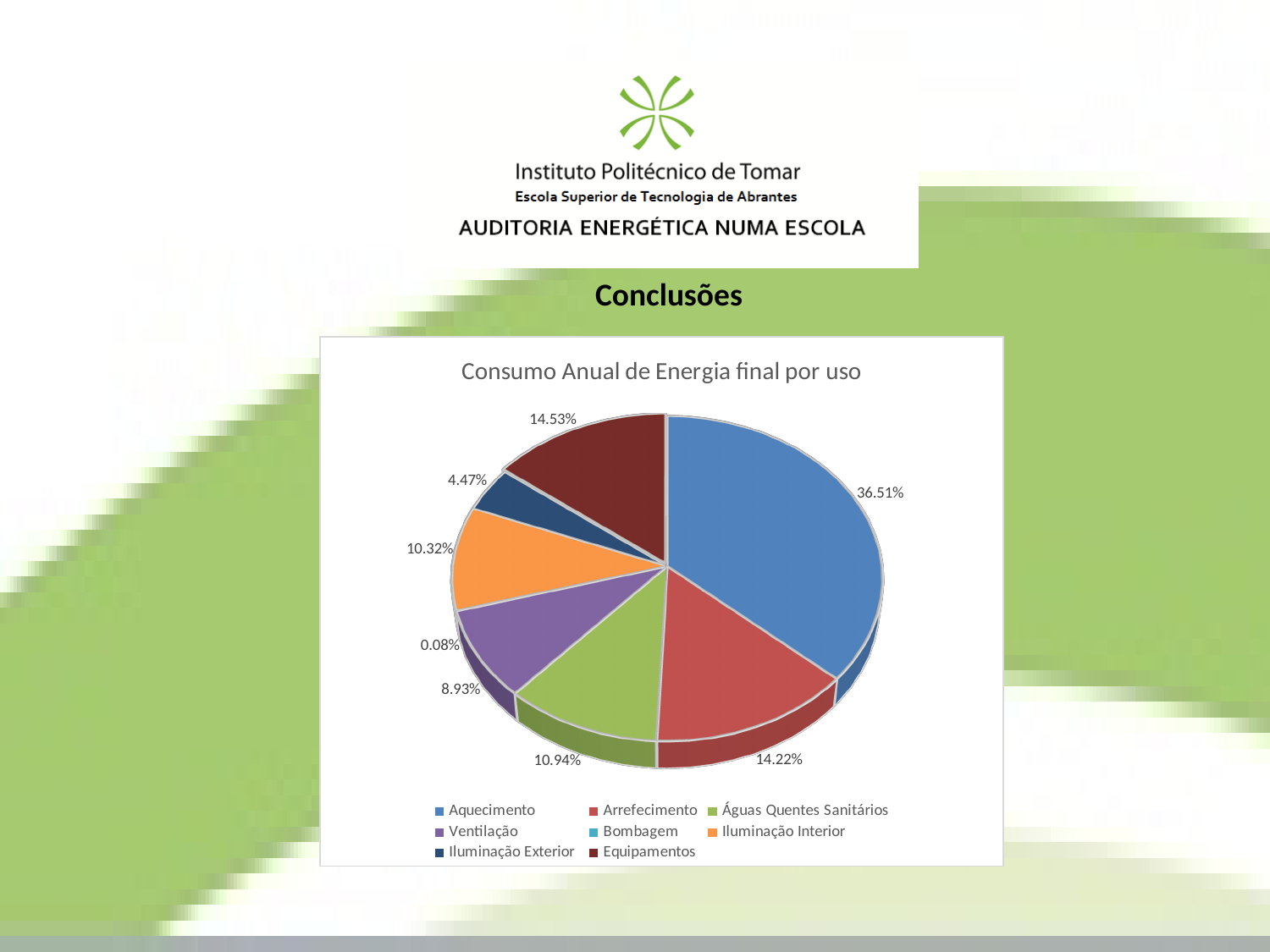
What is the value shown for Arrefecimento? 14.22% Which category has the smallest slice of the pie? Bombagem What is the value shown for Equipamentos? 14.53% What is the value shown for Iluminação Exterior? 4.47% What is the difference between the shares of Aquecimento and Arrefecimento? 22.29% Which category has the largest slice of the pie? Aquecimento What is the value shown for Ventilação? 8.93% How many categories does the legend of the pie chart list? 8 What share of the pie does Aquecimento represent? 36.51% What kind of chart is shown on the slide? pie chart Which is larger, the share of Águas Quentes Sanitários or the share of Iluminação Interior? Águas Quentes Sanitários What is the title of the chart? Consumo Anual de Energia final por uso